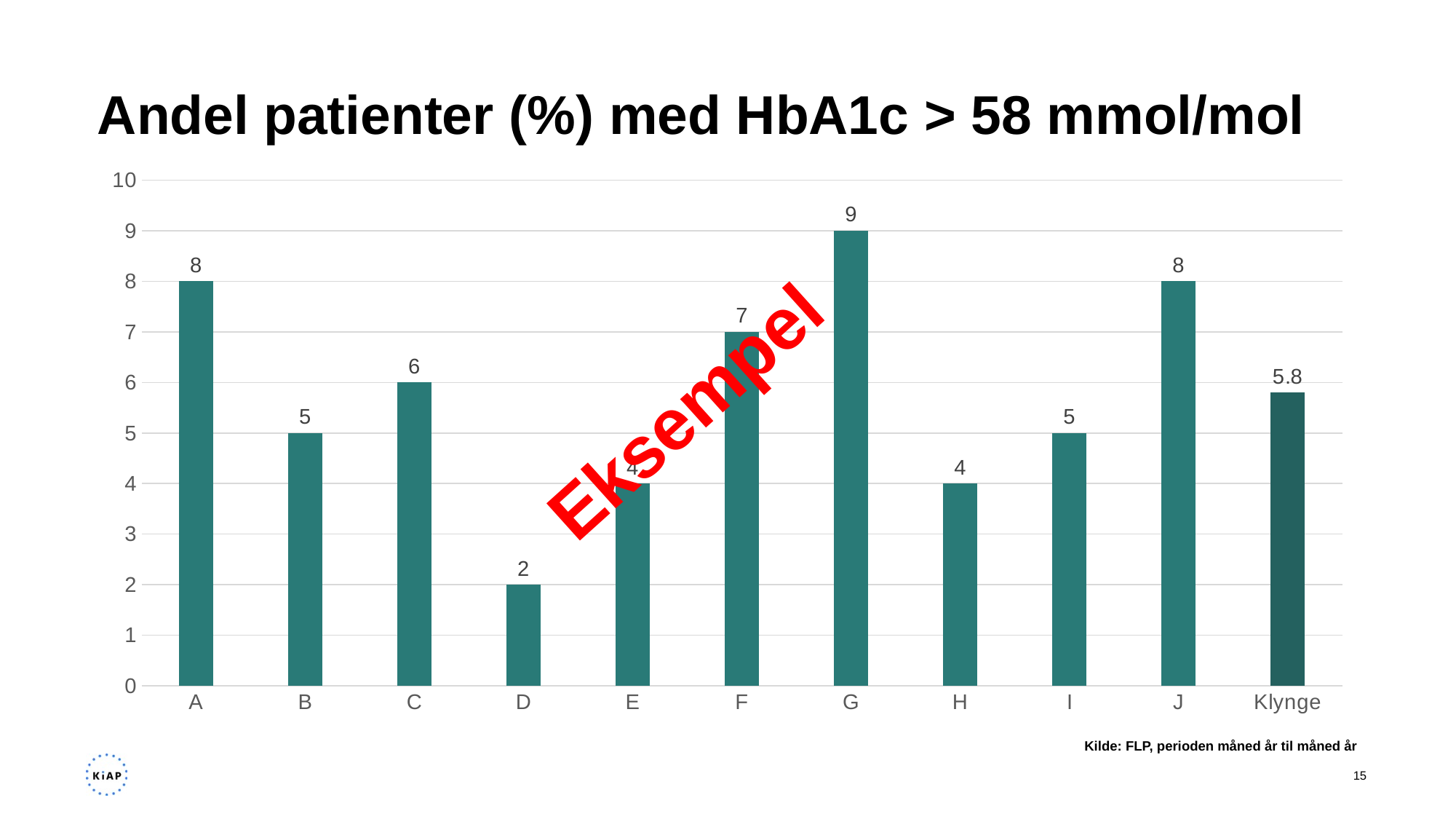
Which category has the highest value? G What kind of chart is shown? bar chart What is the value for Klynge? 5.8 Is the value for F greater or less than 5? greater How many categories are shown on the x axis? 11 What is the title of the chart? Andel patienter (%) med HbA1c > 58 mmol/mol What is the value for category G? 9 What is the difference between the values for G and D? 7 What is the value for category D? 2 Which category has the lowest value? D What is the difference between the values for A and B? 3 Which is larger, the value for C or the value for H? C